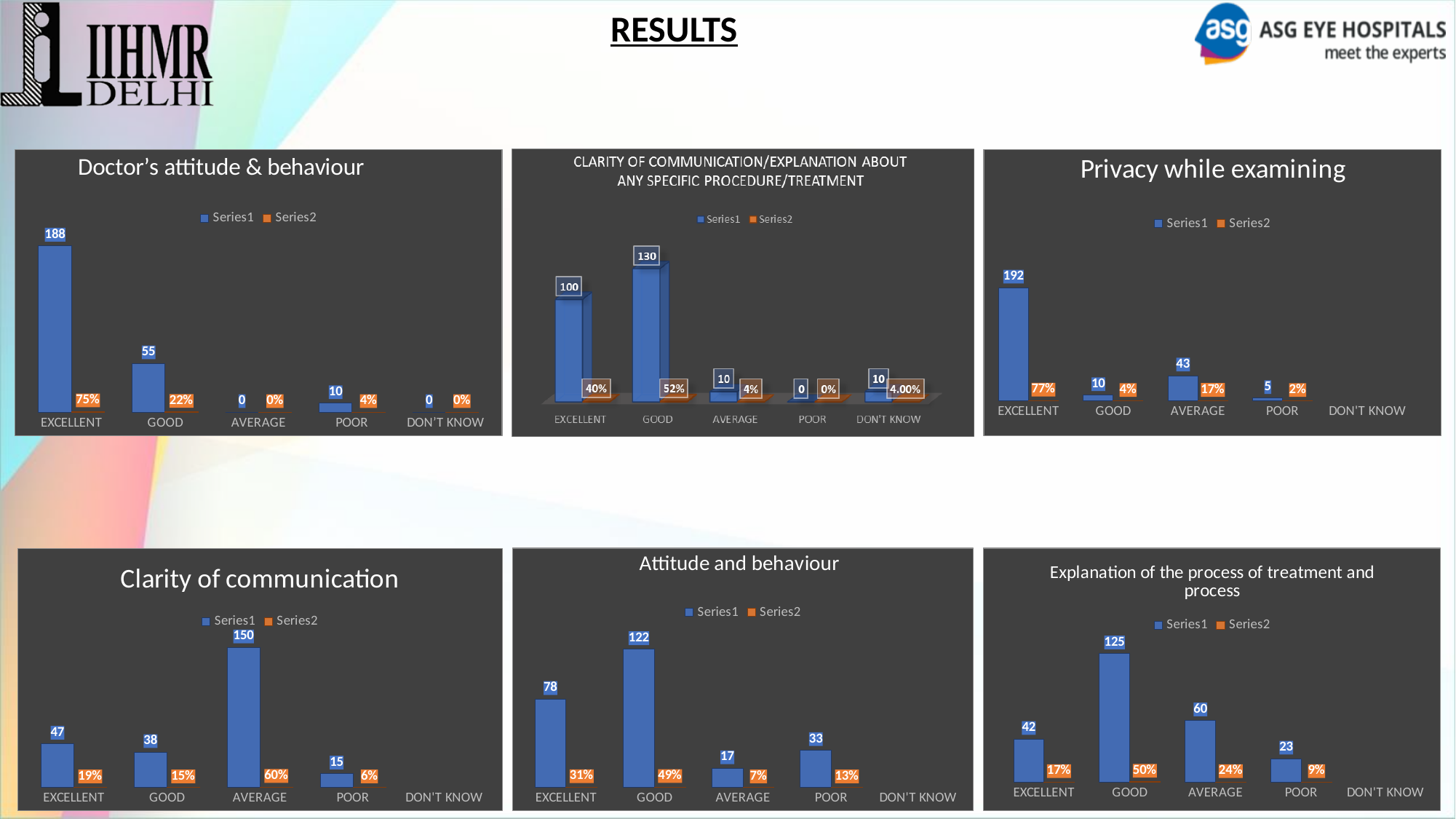
In the 'Clarity of communication' chart (bottom left), which category has the highest Series1 value? AVERAGE In the 'Doctor's attitude & behaviour' chart, what is the Series1 value for EXCELLENT? 188 In the 'Privacy while examining' chart, what is the Series2 value for POOR? 2% In the 'Clarity of communication' chart (bottom left), what is the Series2 value for EXCELLENT? 19% In the 'Attitude and behaviour' chart, which is larger: the Series1 value for EXCELLENT or for GOOD? GOOD In the 'Attitude and behaviour' chart, what is the Series1 value for POOR? 33 In the 'Privacy while examining' chart, what is the difference between the Series1 values for EXCELLENT and AVERAGE? 149 How many series does the legend list in the 'Explanation of the process of treatment and process' chart? 2 In the 'Doctor's attitude & behaviour' chart, what is the Series2 value for GOOD? 22% In the 'Clarity of communication/explanation about any specific procedure/treatment' chart, which category has the highest Series1 value? GOOD In the 'Clarity of communication/explanation about any specific procedure/treatment' chart, what is the Series2 value for DON'T KNOW? 4.00% In the 'Explanation of the process of treatment and process' chart, what is the Series2 value for AVERAGE? 24%